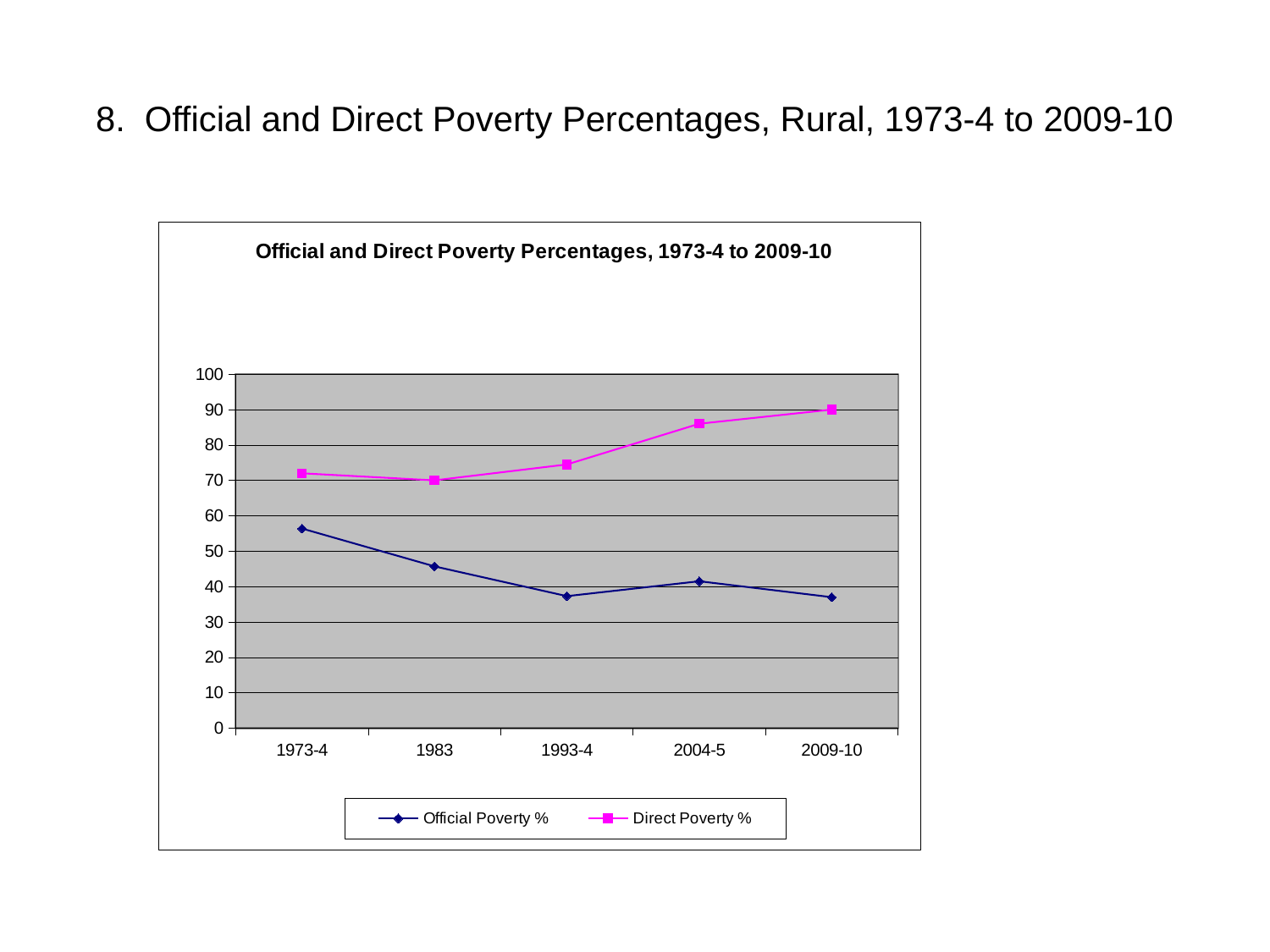
Does Direct Poverty % generally rise or fall from 1973-4 to 2009-10? rise How many time periods are plotted along the x axis? 5 Is the value for Official Poverty % in 1973-4 greater or less than 50? greater What kind of chart is shown on the slide? line chart Is the value for Direct Poverty % in 2004-5 greater or less than 80? greater What is the title of the chart? Official and Direct Poverty Percentages, 1973-4 to 2009-10 Is the value for Official Poverty % in 1993-4 greater or less than 40? less How many series does the legend list? 2 Which is larger in 2004-5, Official Poverty % or Direct Poverty %? Direct Poverty % Does Official Poverty % generally rise or fall from 1973-4 to 2009-10? fall In which period is Direct Poverty % highest? 2009-10 In which period is Official Poverty % highest? 1973-4